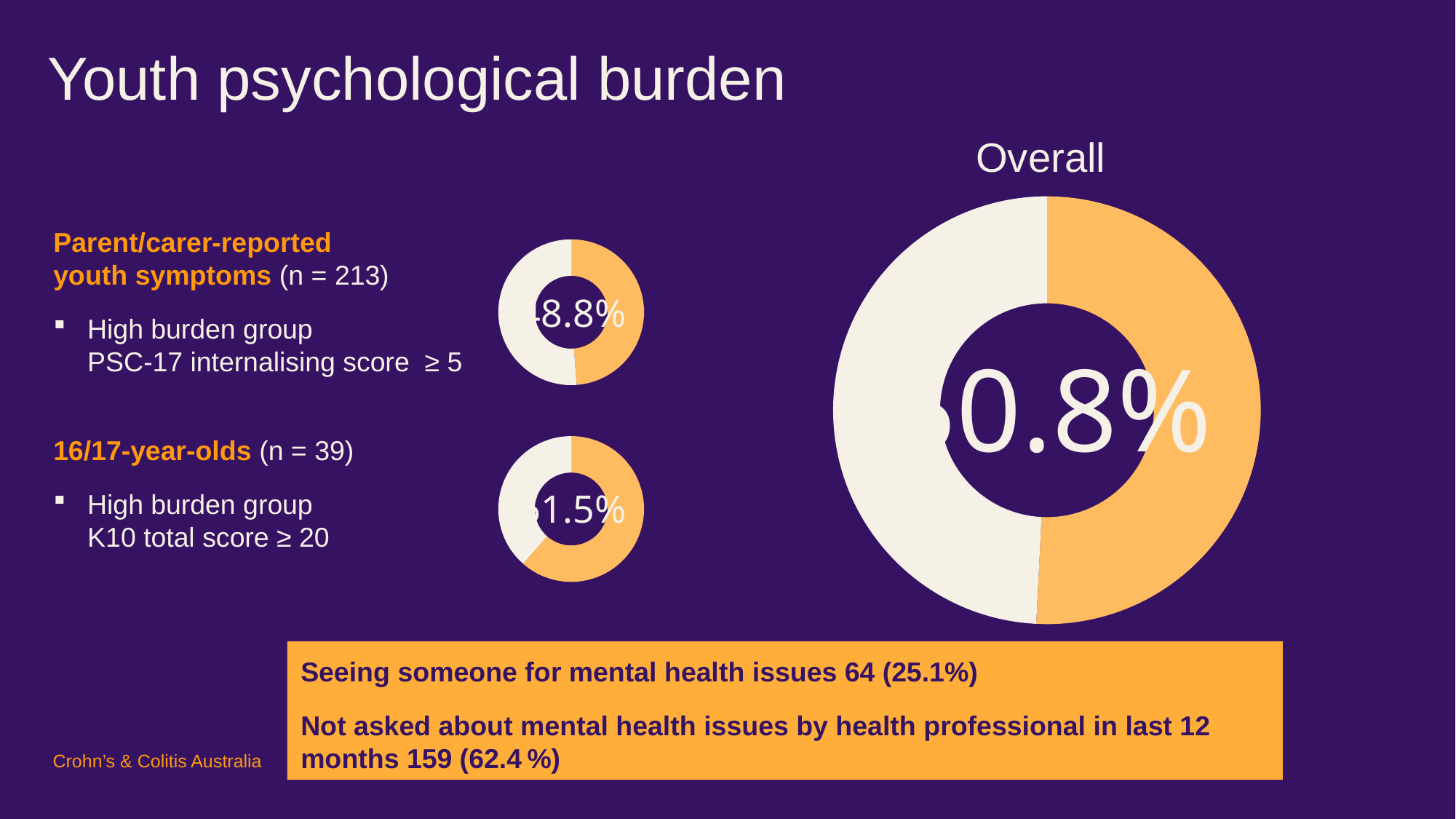
In the donut chart for 16/17-year-olds, is the orange share greater or less than 50%? greater Which group has the larger orange share: parent/carer-reported youth symptoms or 16/17-year-olds? 16/17-year-olds Which two colours are used for the segments of the donut charts? Orange and cream In the donut chart for parent/carer-reported youth symptoms, is the orange share greater or less than 75%? less In the Overall donut chart, is the orange share greater or less than 25%? greater What is the title above the large donut chart on the right? Overall How many donut charts are shown on the slide? 3 What kind of chart is used to show the Overall youth psychological burden? Donut (pie) chart